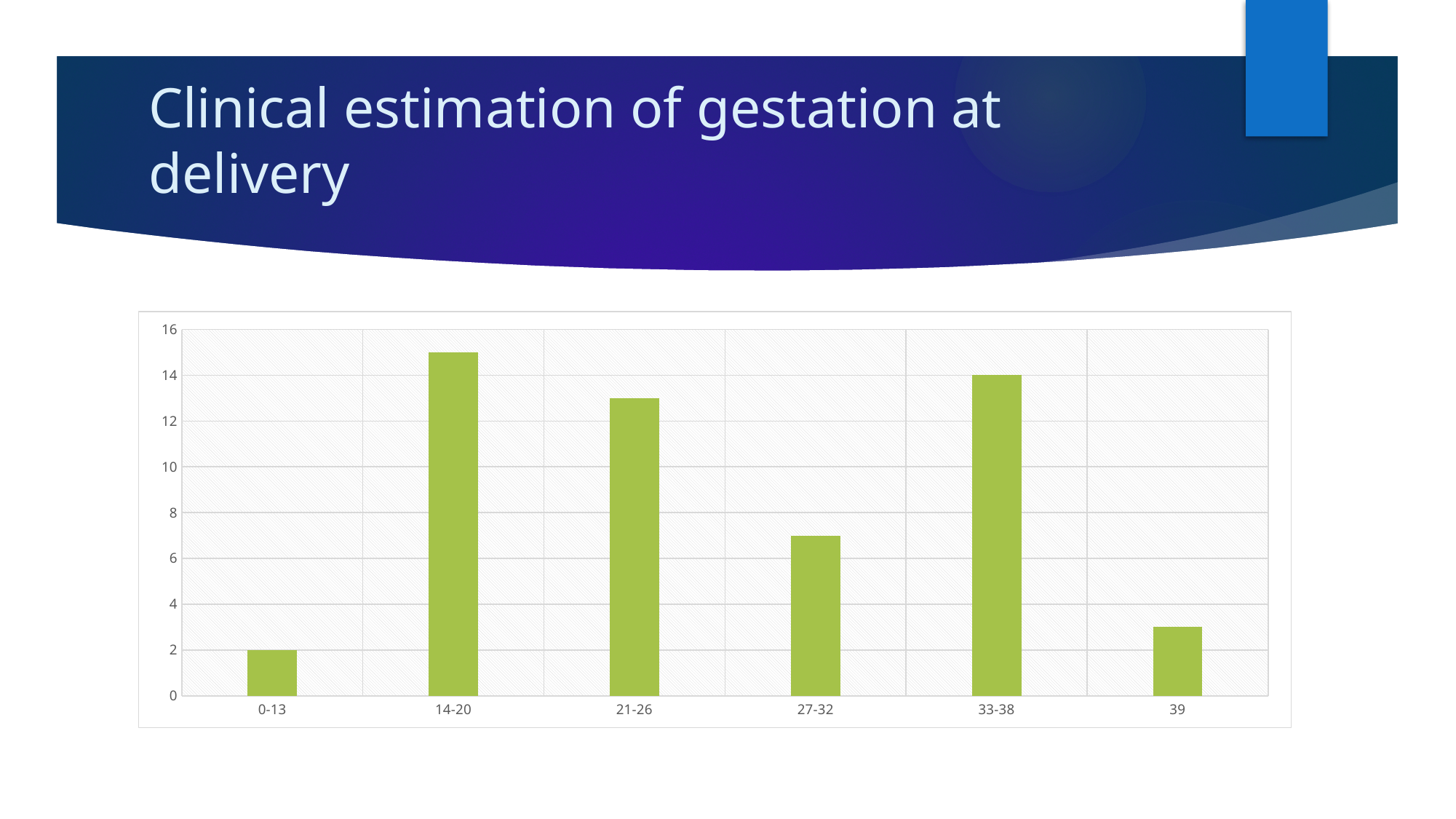
What is the value for the 33-38 category? 14 Which has the larger value, 21-26 or 27-32? 21-26 Is the value for 39 greater or less than 4? less Is the value for 14-20 greater or less than 14? greater Which category has the highest value? 14-20 What kind of chart is shown on the slide? bar chart How many categories are shown on the x axis? 6 What is the title of the slide containing the chart? Clinical estimation of gestation at delivery What is the value for the 0-13 category? 2 What is the difference between the values for 33-38 and 0-13? 12 Which category has the lowest value? 0-13 Is the value for 27-32 greater or less than 8? less